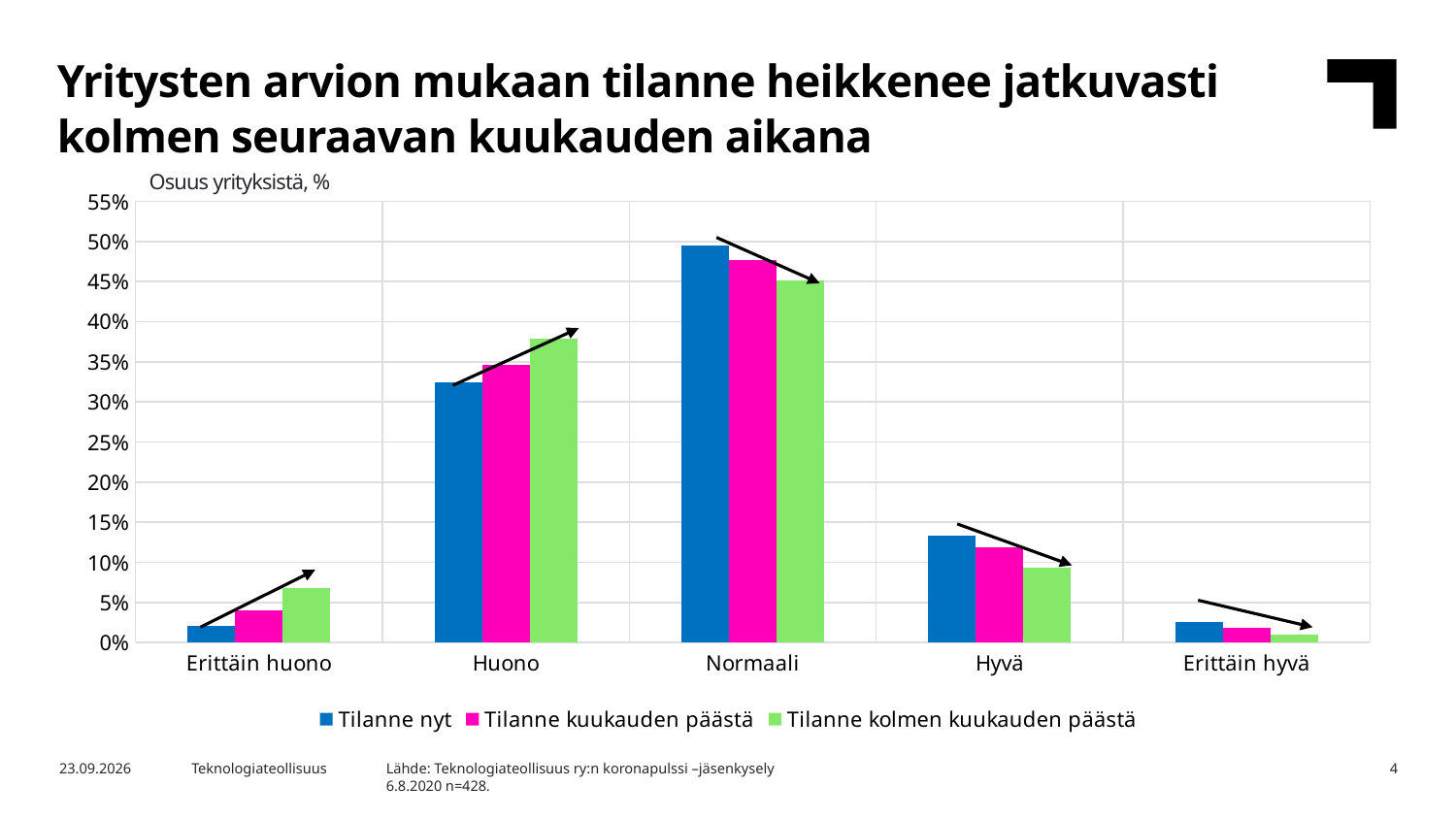
Is the value for 'Hyvä' in the series 'Tilanne kolmen kuukauden päästä' greater or less than 10%? less How many categories are shown on the x axis? 5 For the category 'Huono', which series has the larger value: 'Tilanne nyt' or 'Tilanne kolmen kuukauden päästä'? Tilanne kolmen kuukauden päästä What kind of chart is shown on the slide? bar chart Is the value for 'Normaali' in the series 'Tilanne nyt' greater or less than 45%? greater How many series does the legend list? 3 Is the value for 'Huono' in the series 'Tilanne nyt' greater or less than 30%? greater Across the three series, do the values for 'Normaali' rise or fall from 'Tilanne nyt' to 'Tilanne kolmen kuukauden päästä'? fall For the category 'Hyvä', which series has the larger value: 'Tilanne nyt' or 'Tilanne kuukauden päästä'? Tilanne nyt What is the label shown above the y axis of the chart? Osuus yrityksistä, % Which category has the lowest value for the series 'Tilanne kolmen kuukauden päästä'? Erittäin hyvä Which category has the highest value for the series 'Tilanne nyt'? Normaali